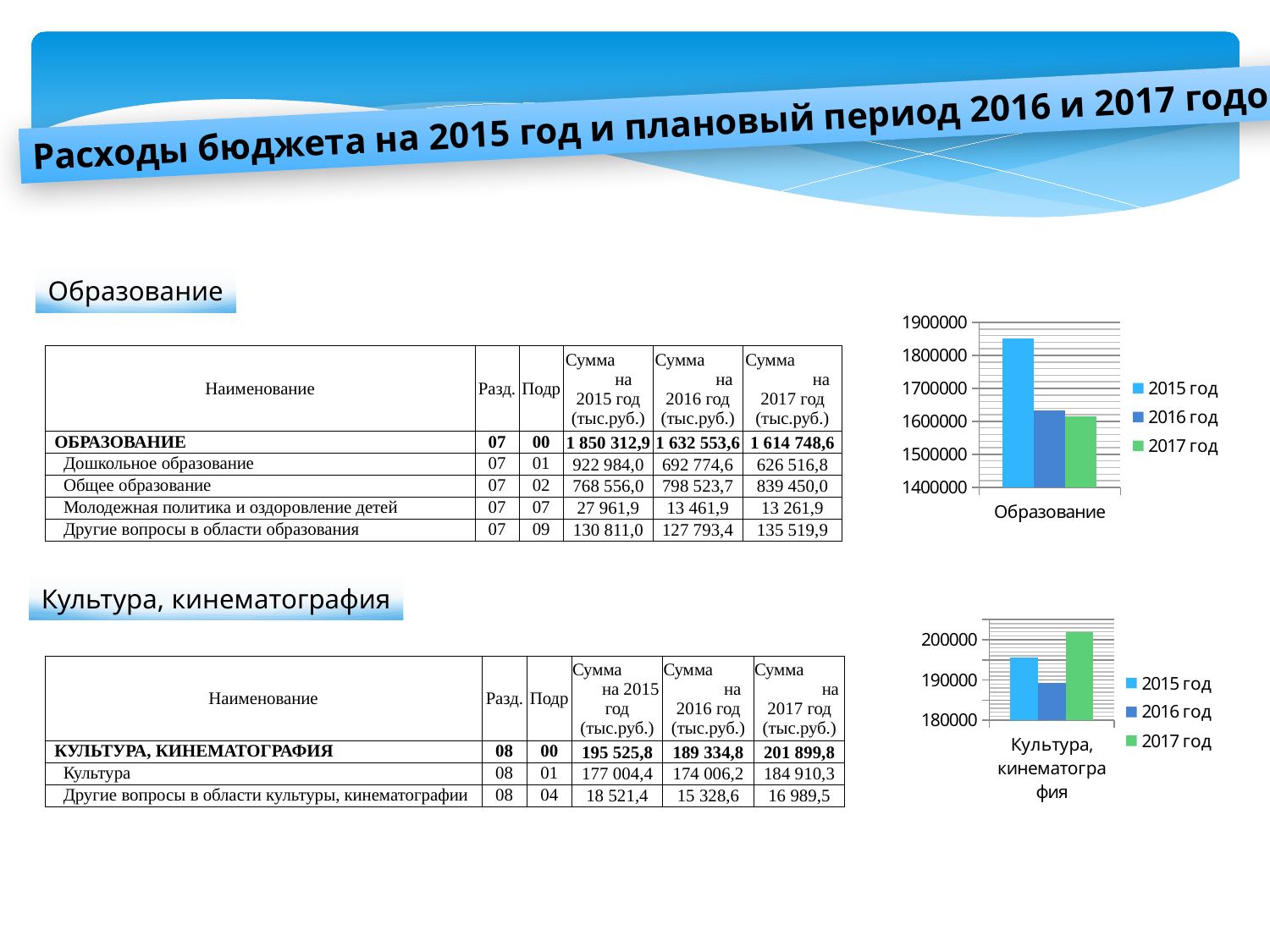
What colour are the bars for 2017 год in the charts on the slide? green In the "Культура, кинематография" chart, which year has the lowest value? 2016 год In the "Образование" chart, which is larger, the value for 2015 год or the value for 2017 год? 2015 год How many series does the legend of the "Образование" chart list? 3 In the "Образование" chart, is the value for 2015 год greater or less than 1800000? greater In the "Культура, кинематография" chart, is the value for 2017 год greater or less than 200000? greater What kind of chart is the chart titled "Образование"? bar chart In the "Образование" chart, which year has the highest value? 2015 год In the "Образование" chart, is the value for 2016 год greater or less than 1700000? less In the "Культура, кинематография" chart, which year has the highest value? 2017 год In the "Культура, кинематография" chart, which is larger, the value for 2015 год or the value for 2016 год? 2015 год